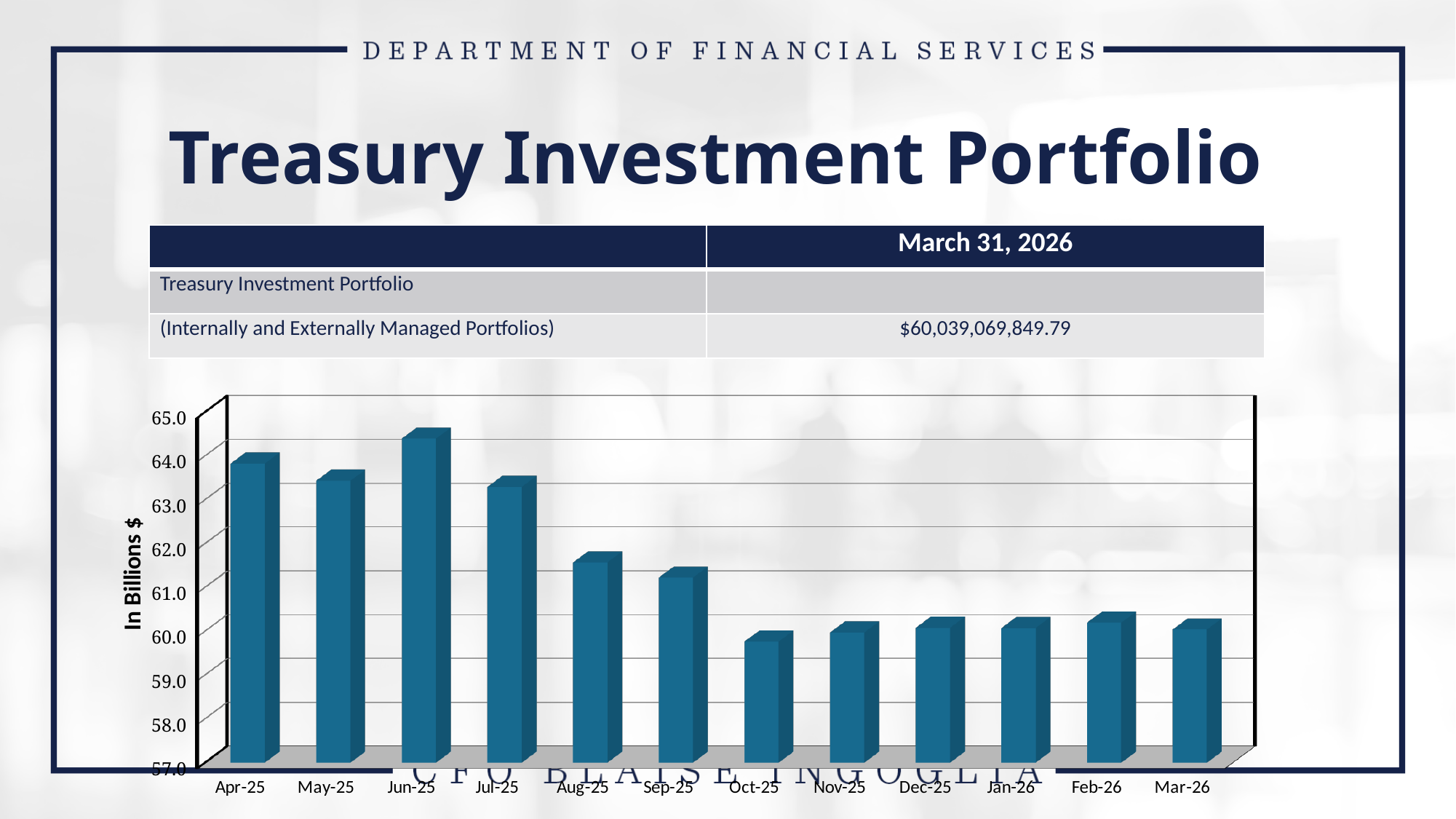
Is the value for Aug-25 greater or less than 62.0? less What kind of chart is shown on the slide? bar chart Is the value for Apr-25 greater or less than 63.0? greater Which is larger, the value for Aug-25 or the value for Oct-25? Aug-25 Which is larger, the value for Apr-25 or the value for Jul-25? Apr-25 What is the label on the vertical axis of the chart? In Billions $ Is the value for Oct-25 greater or less than 60.0? less Which month has the highest value on the chart? Jun-25 How many months are plotted on the chart? 12 Overall, do the values rise or fall from Apr-25 to Mar-26? fall Which month has the lowest value on the chart? Oct-25